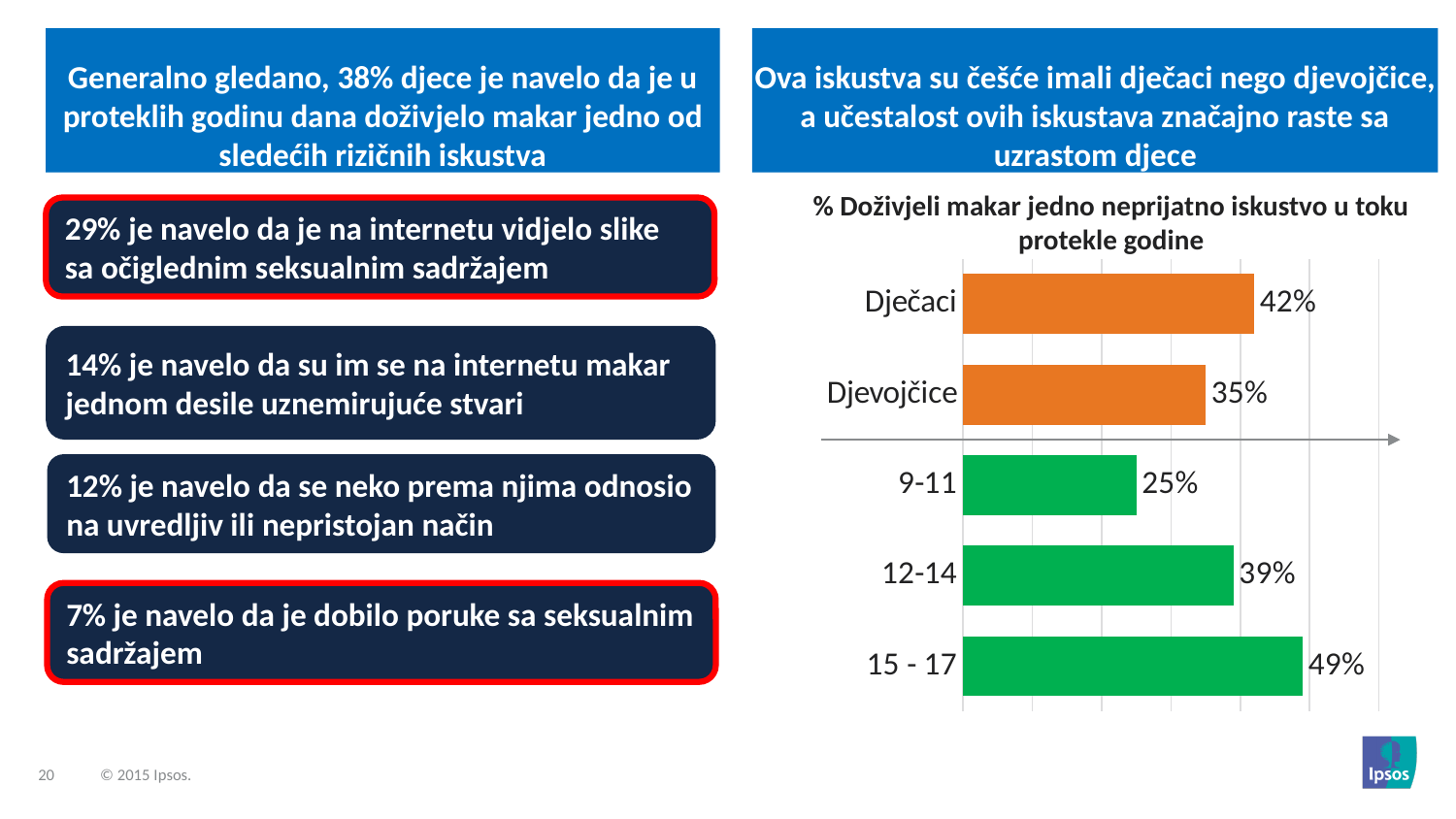
What kind of chart is shown? Bar chart What is the value for the 15 - 17 age group? 49% What is the value for Djevojčice? 35% What is the value for the 9-11 age group? 25% What is the title of the chart? % Doživjeli makar jedno neprijatno iskustvo u toku protekle godine What is the difference between the values for Dječaci and Djevojčice? 7% Which is larger, the value for 12-14 or the value for 9-11? 12-14 How many categories are shown in the chart? 5 What is the value for Dječaci? 42% Which category has the highest value? 15 - 17 Which category has the lowest value? 9-11 What is the difference between the values for the 15 - 17 and 9-11 age groups? 24%